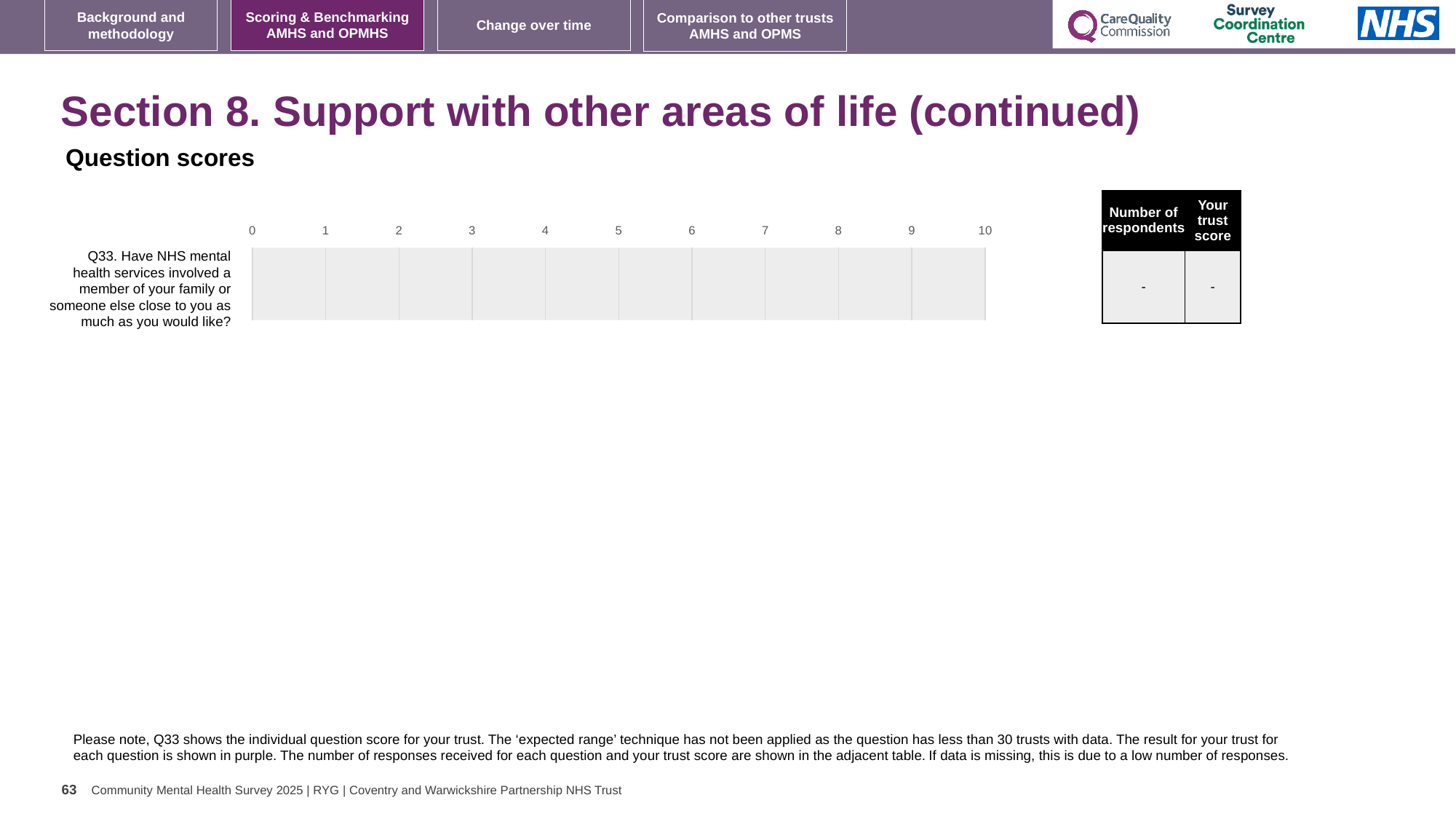
What is the trust score shown in the table for Q33? - What is the highest value shown on the chart's horizontal axis? 10 How many questions (categories) are plotted on the chart? 1 What is the lowest value shown on the chart's horizontal axis? 0 What is the number of respondents shown in the table for Q33? - Is a bar plotted for Q33 on the chart? No What kind of chart is shown on the slide? bar chart